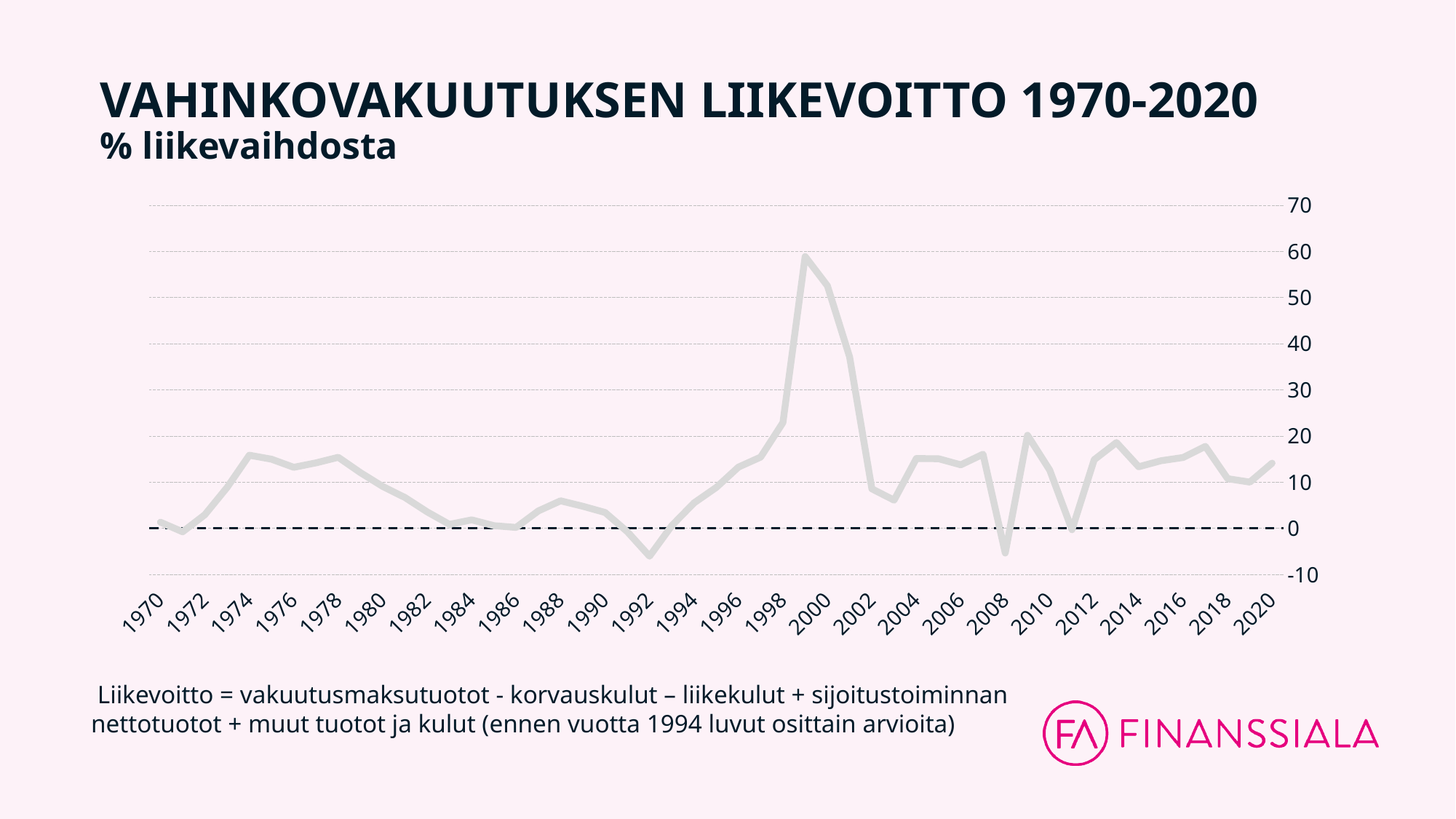
Is the value for 2014 greater or less than 10? greater Is the value for 1992 greater or less than 0? less In what unit are the values expressed, according to the subtitle? % liikevaihdosta What is the title of the chart? VAHINKOVAKUUTUKSEN LIIKEVOITTO 1970-2020 Which year has the larger value, 2000 or 2020? 2000 Is the value for 2000 greater or less than 30? greater Does the line rise or fall between 2000 and 2002? fall What kind of chart is shown on the slide? line chart Which year has the larger value, 1974 or 1990? 1974 How many year labels are shown on the x axis? 26